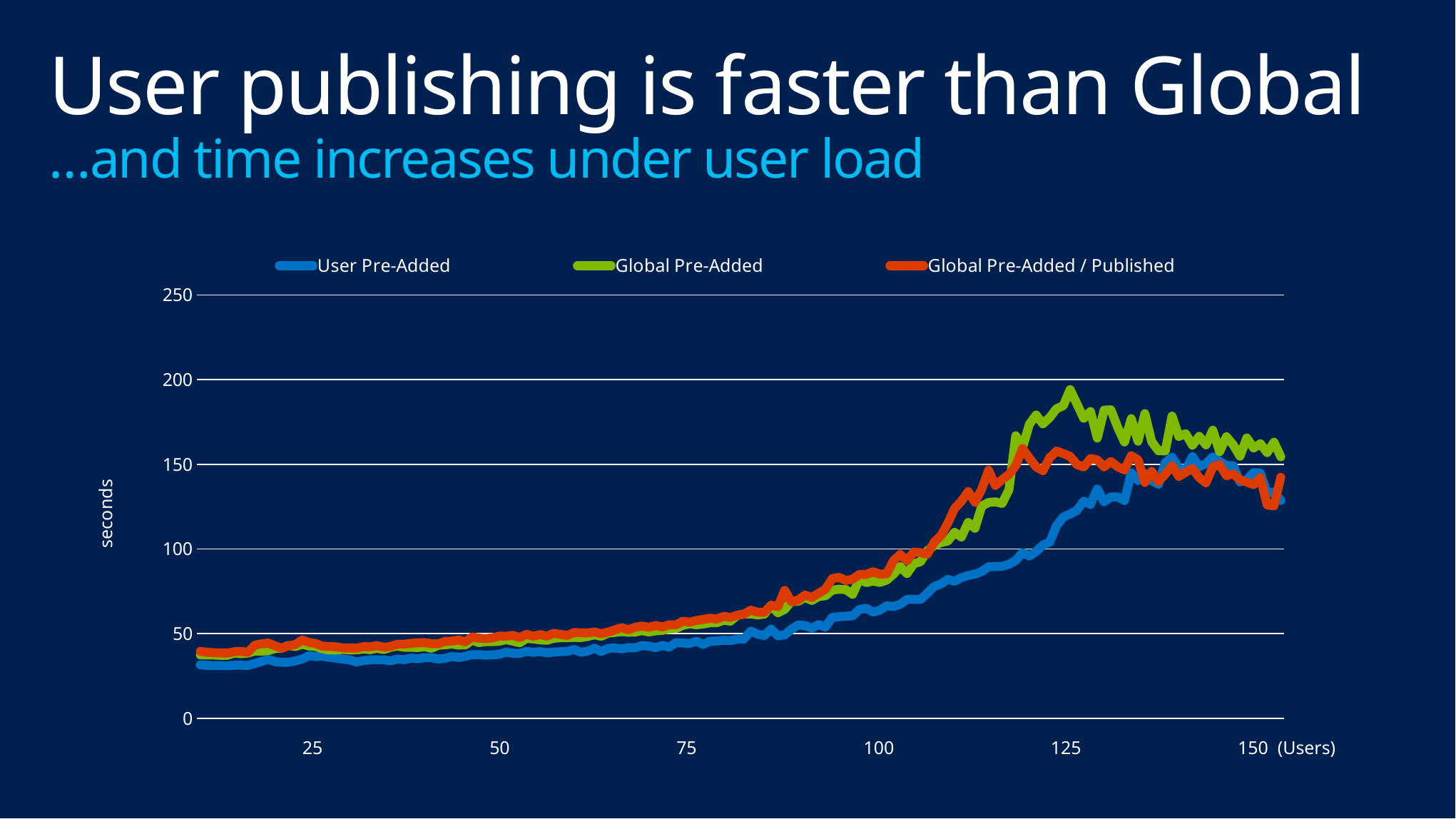
Which series reaches the highest peak value on the chart? Global Pre-Added Is the value for User Pre-Added at 25 users greater or less than 50? less What kind of chart is shown on the slide? line chart Is the value for User Pre-Added at 100 users greater or less than 100? less Is the value for Global Pre-Added / Published at 75 users greater or less than 100? less What are the three series named in the legend? User Pre-Added, Global Pre-Added, Global Pre-Added / Published At 100 users, which is higher: Global Pre-Added / Published or User Pre-Added? Global Pre-Added / Published How many series does the legend list? 3 At 125 users, which is higher: Global Pre-Added or User Pre-Added? Global Pre-Added What is the label on the vertical axis? seconds Does the User Pre-Added series generally rise or fall as the number of users increases? rise